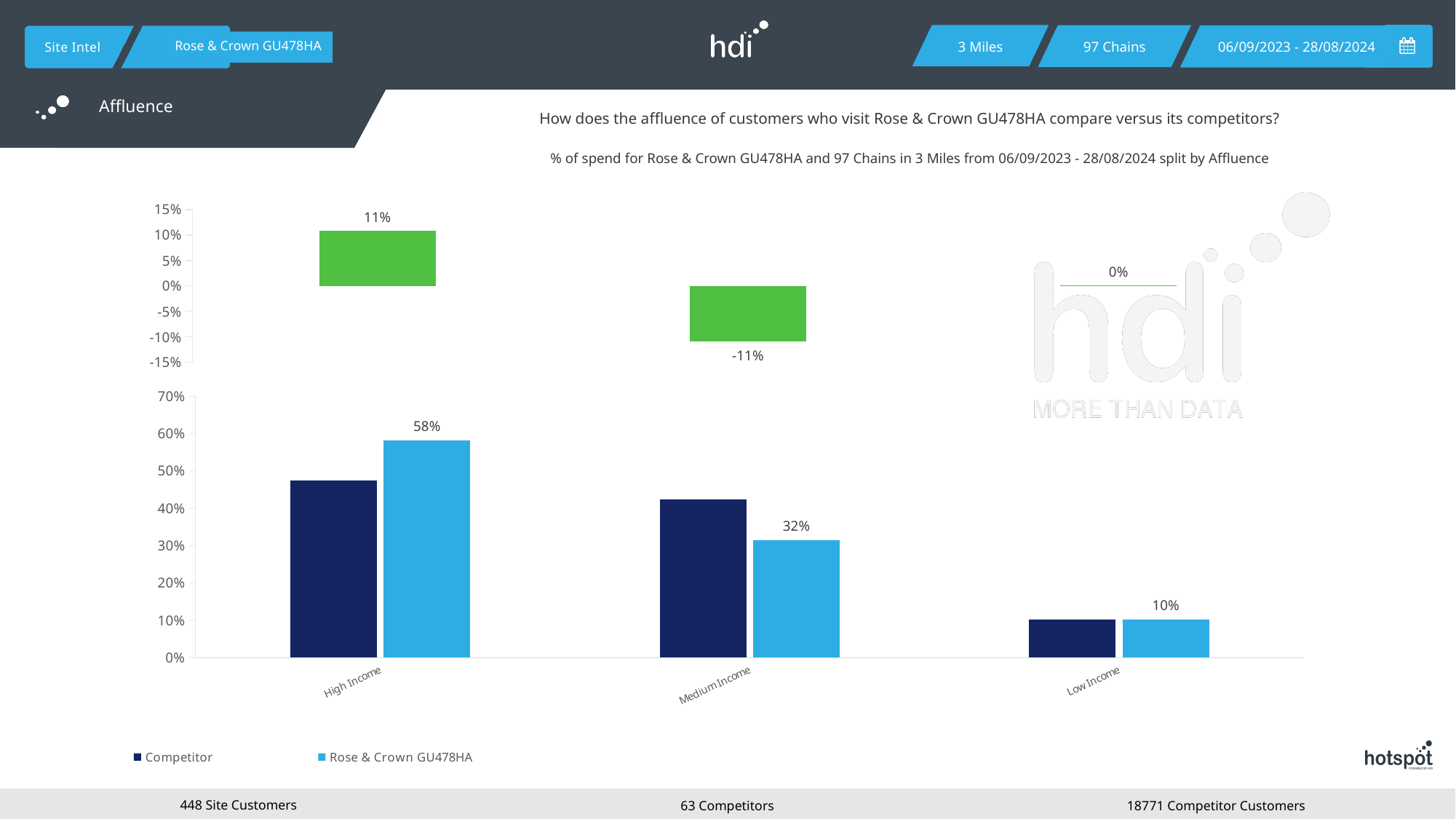
In the bottom chart, what is the value for Rose & Crown GU478HA in the Low Income category? 10% In the bottom chart, is the Competitor value for High Income greater or less than 40%? greater How many series does the legend of the bottom chart list? 2 In the bottom chart, what is the value for Rose & Crown GU478HA in the High Income category? 58% In the bottom chart, which is larger in the High Income category: Competitor or Rose & Crown GU478HA? Rose & Crown GU478HA In the bottom chart, which category has the highest value for Rose & Crown GU478HA? High Income In the top chart, what is the value shown for the High Income category? 11% In the bottom chart, is the Competitor value for Medium Income greater or less than 50%? less In the top chart, what is the value shown for the Medium Income category? -11% In the top chart, what is the value shown for the Low Income category? 0% In the bottom chart, what is the difference between the Rose & Crown GU478HA values for High Income and Medium Income? 26% In the bottom chart, what is the value for Rose & Crown GU478HA in the Medium Income category? 32%